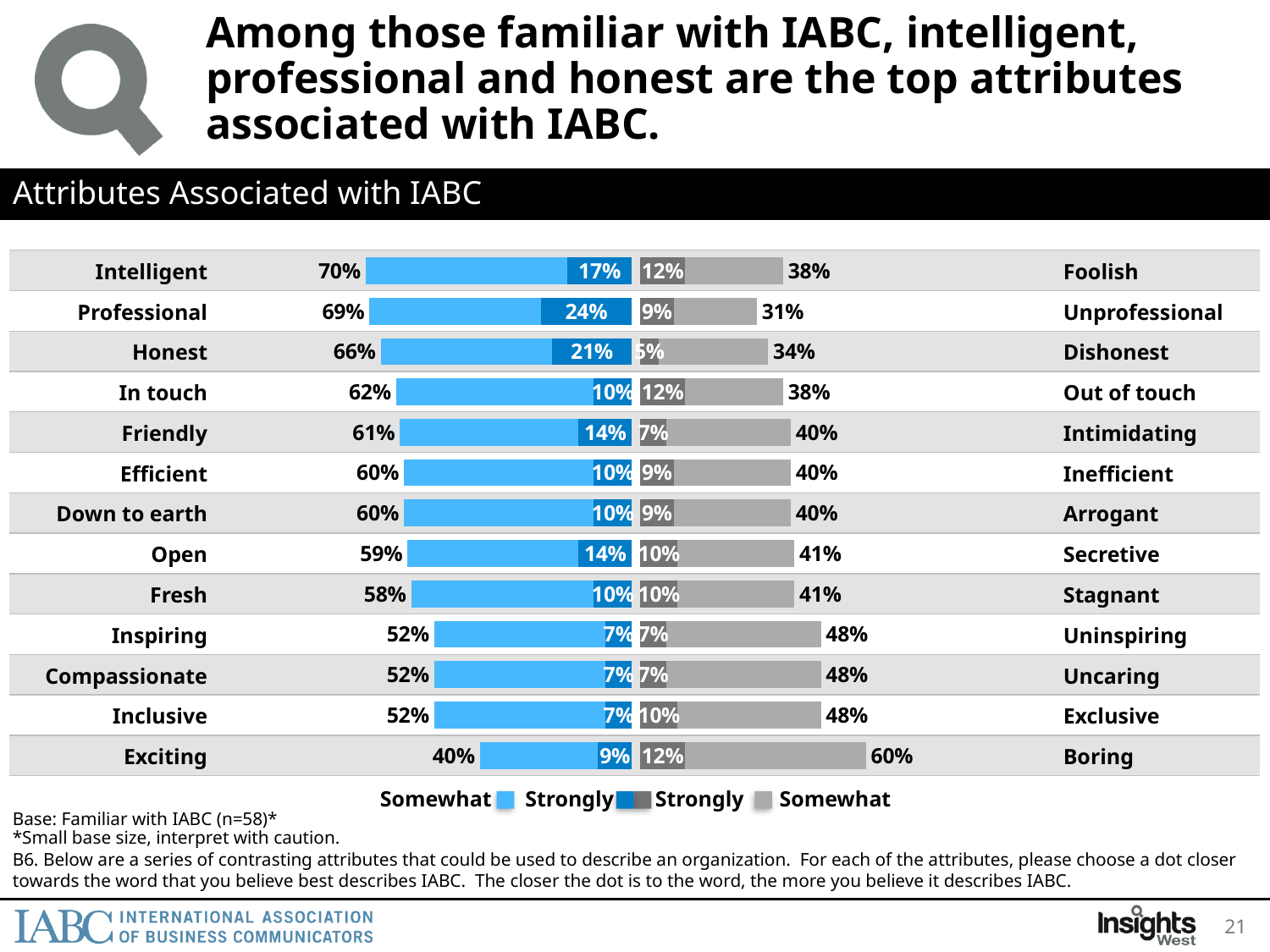
How many pairs of contrasting attributes are shown in the chart? 13 What type of chart is used to show the attributes associated with IABC? Bar chart What percentage strongly associate "Professional" with IABC? 24% Which positive attribute on the left has the highest overall percentage? Intelligent What percentage of respondents associate "Boring" with IABC? 60% Which has a higher overall percentage, "Professional" or "Honest"? Professional Which positive attribute on the left has the lowest overall percentage? Exciting What is the title of the chart? Attributes Associated with IABC What is the difference in percentage points between the overall share for "Intelligent" and the overall share for "Foolish"? 32 percentage points What percentage strongly associate "Foolish" with IABC? 12% What percentage of respondents associate the attribute "Intelligent" with IABC? 70% How many entries does the chart legend list? 4